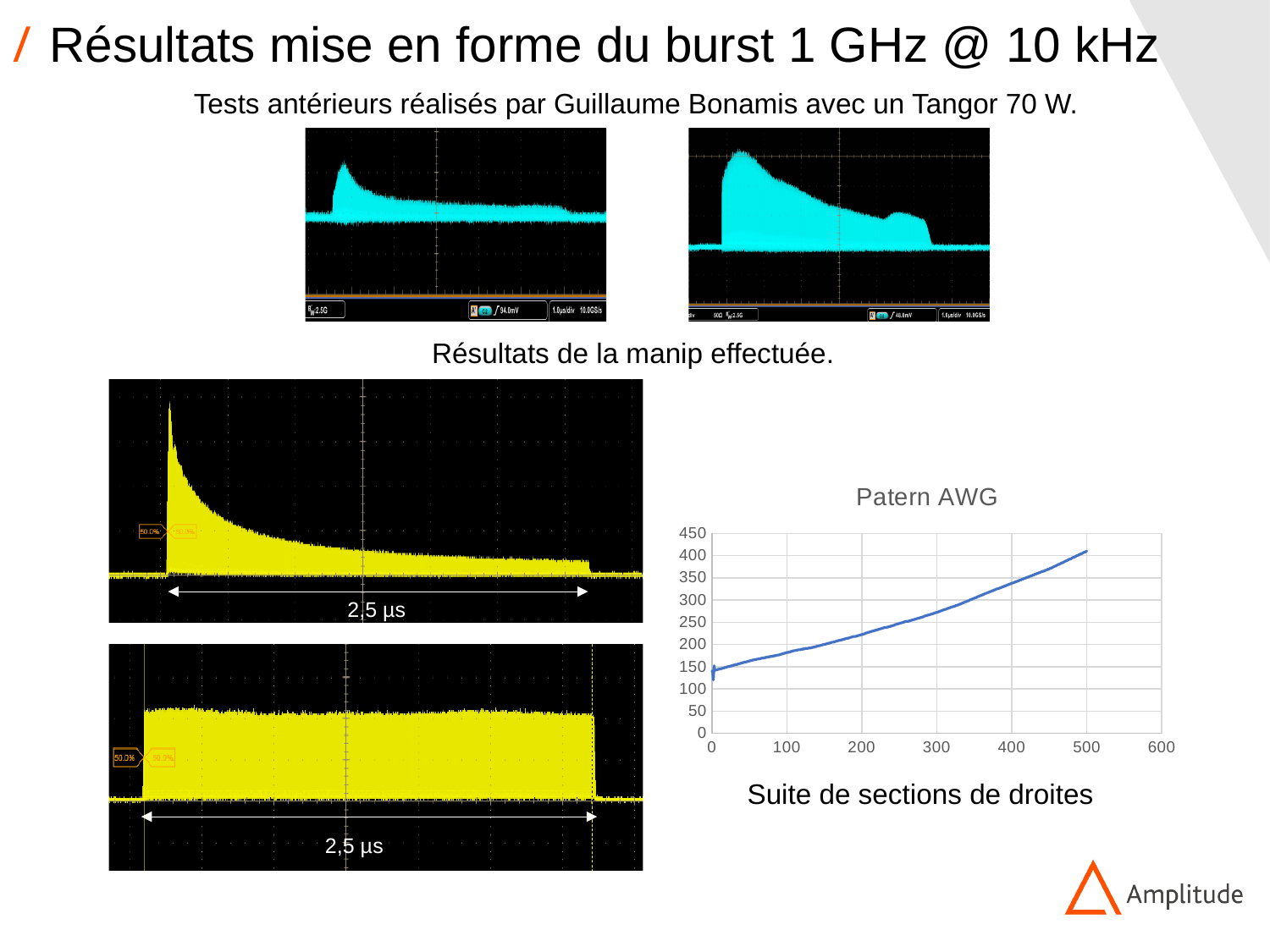
In the "Patern AWG" chart, is the value at x = 500 greater or less than 350? greater In the "Patern AWG" chart, is the value at x = 0 greater or less than 100? greater In the "Patern AWG" chart, do the values rise or fall as x increases from 0 to 500? rise What kind of chart is the "Patern AWG" chart? line chart What is the highest tick value shown on the y axis of the "Patern AWG" chart? 450 In the "Patern AWG" chart, is the value at x = 200 larger or smaller than the value at x = 400? smaller How many lines are plotted in the "Patern AWG" chart? 1 In the "Patern AWG" chart, is the value at x = 100 greater or less than 150? greater What is the title of the line chart on the right of the slide? Patern AWG In the "Patern AWG" chart, at which end of the x axis does the line reach its highest value? the right end (x = 500)